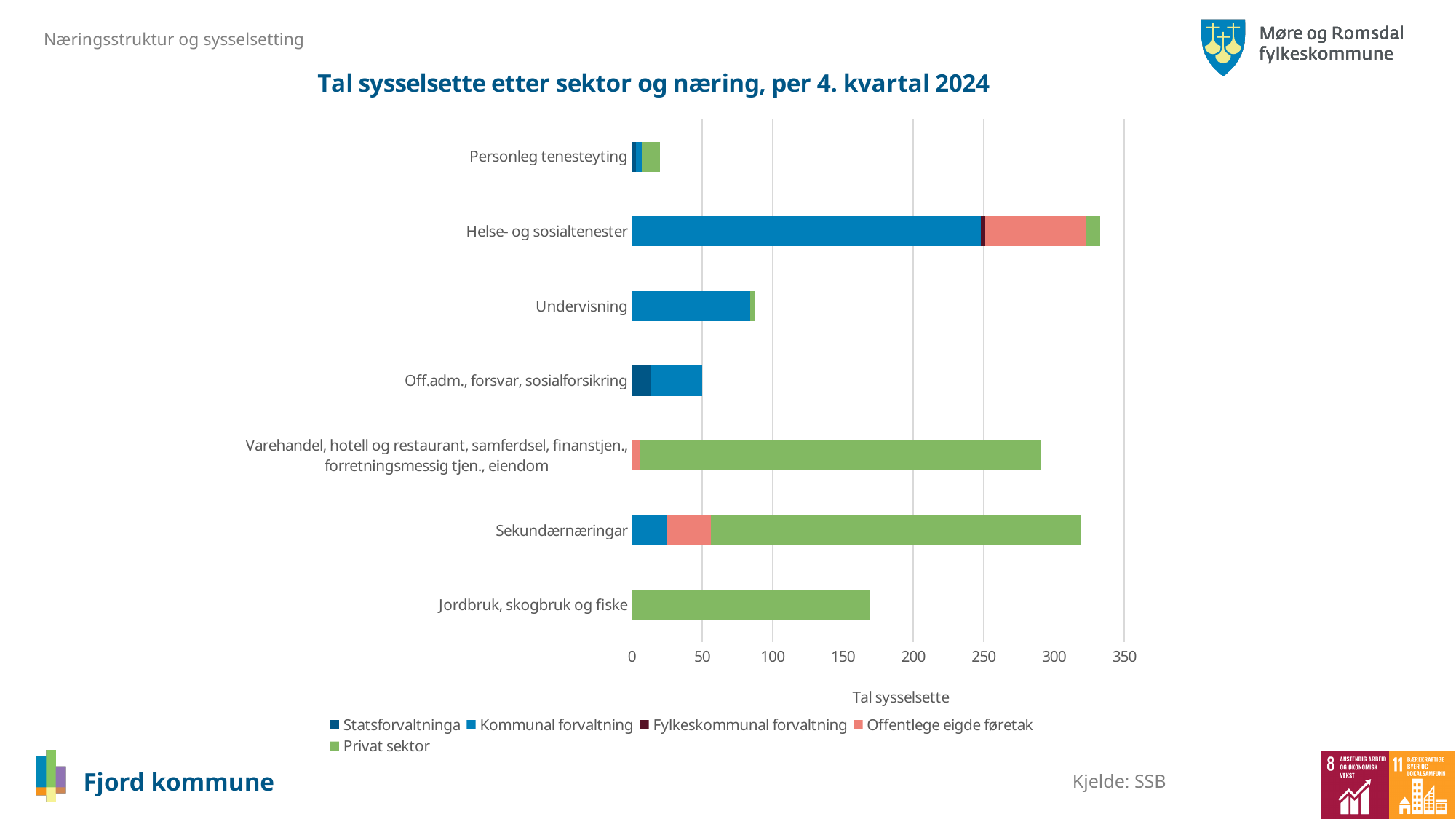
What is the label on the x axis of the chart? Tal sysselsette What is the title of the chart? Tal sysselsette etter sektor og næring, per 4. kvartal 2024 What kind of chart is shown on the slide? bar chart Is the total value for Helse- og sosialtenester greater or less than 300? greater Is the total value for Jordbruk, skogbruk og fiske greater or less than 150? greater Is the total value for Personleg tenesteyting greater or less than 50? less Which has a larger total: Jordbruk, skogbruk og fiske or Undervisning? Jordbruk, skogbruk og fiske How many series does the legend list? 5 Which category has the lowest total number of employees? Personleg tenesteyting How many categories (næringar) are shown on the y axis of the chart? 7